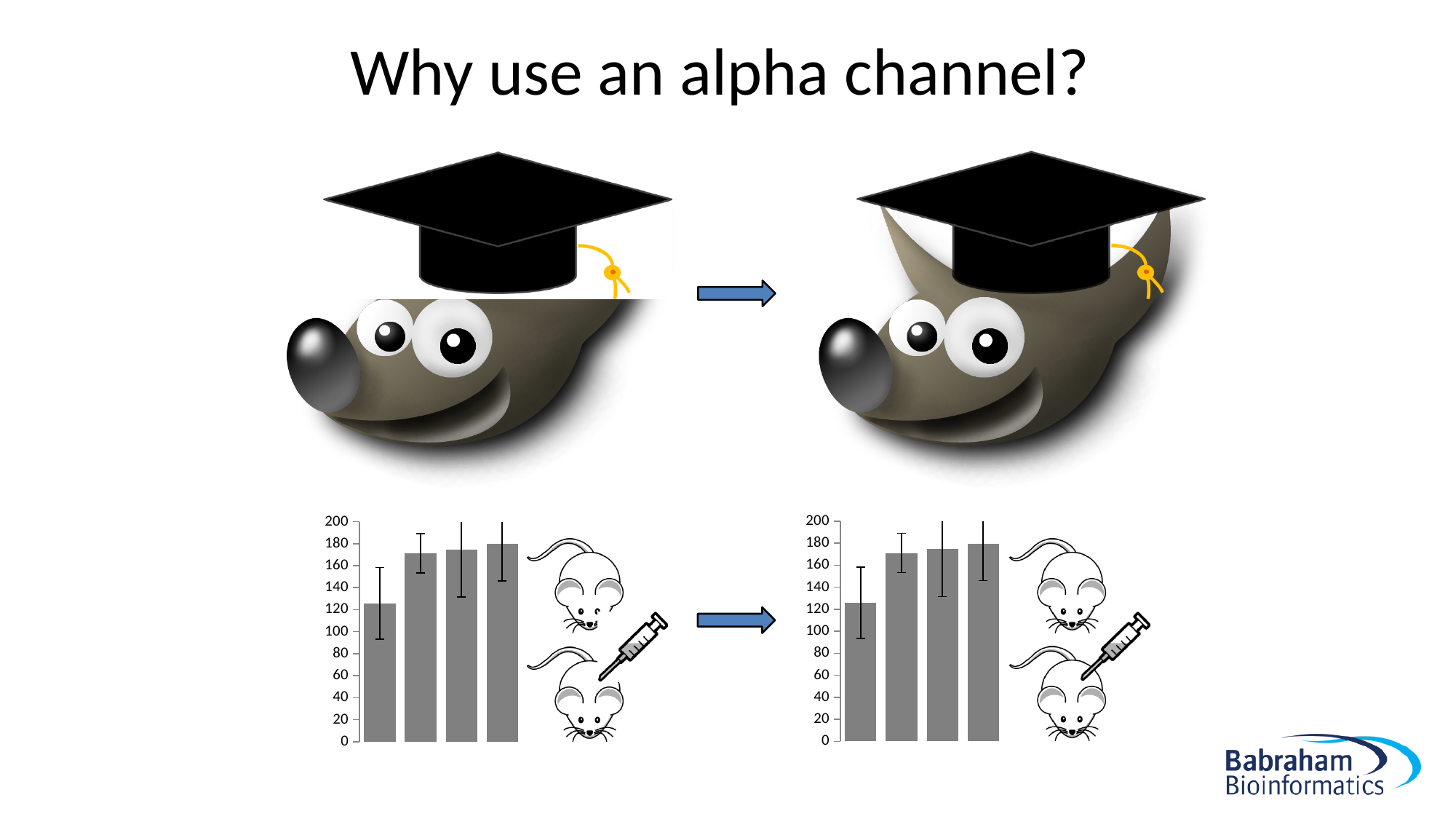
In the right bar chart, which is larger, the first bar or the second bar? the second bar How many bars does the left bar chart show? 4 What is the highest value shown on the y axis of the right bar chart? 200 In the right bar chart, is the value of the fourth (rightmost) bar greater or less than 160? greater In the left bar chart, which bar is the lowest? the first (leftmost) bar In the left bar chart, is the value of the first (leftmost) bar greater or less than 100? greater What kind of chart is the left chart at the bottom of the slide? bar chart In the left bar chart, is the value of the first (leftmost) bar greater or less than 140? less How many bars does the right bar chart show? 4 What is the step between consecutive tick labels on the y axis of the left bar chart? 20 In the left bar chart, do the bar values rise or fall from left to right? rise